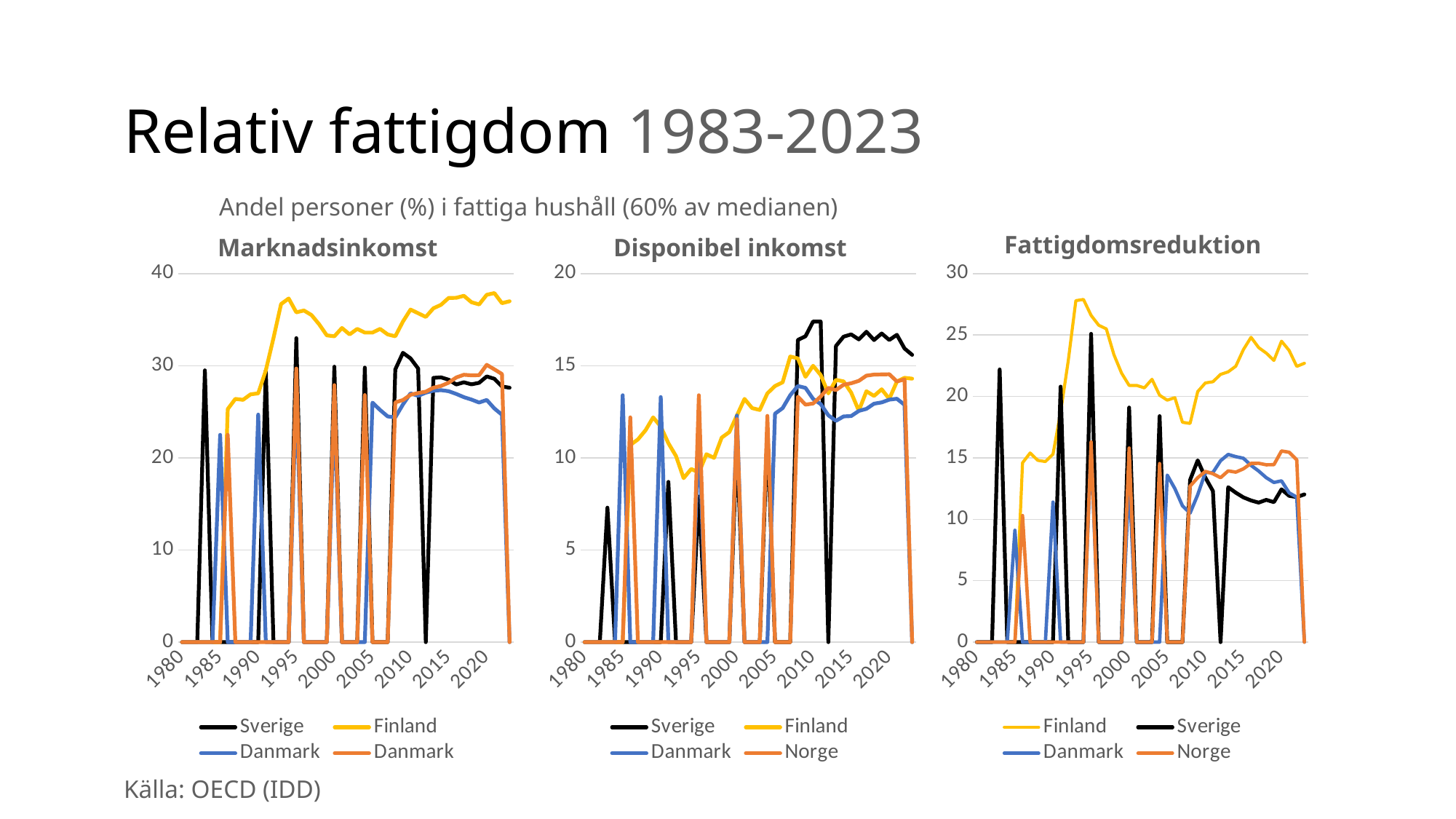
In the "Disponibel inkomst" chart, is the value for Finland in 1995 greater or less than 10? less In the "Marknadsinkomst" chart, is the value for Finland in 2020 greater or less than 30? greater How many series does the legend of the "Disponibel inkomst" chart list? 4 In the "Disponibel inkomst" chart, is the value for Sverige in 2015 greater or less than 15? greater What kind of chart is the "Marknadsinkomst" chart? line chart In the "Marknadsinkomst" chart, which series has the highest value in 2020? Finland How many charts are shown on the slide? 3 What is the title of the rightmost chart? Fattigdomsreduktion In the "Fattigdomsreduktion" chart, does the Finland line rise or fall between 1995 and 2005? fall In the "Disponibel inkomst" chart, which is larger in 2015, Sverige or Danmark? Sverige